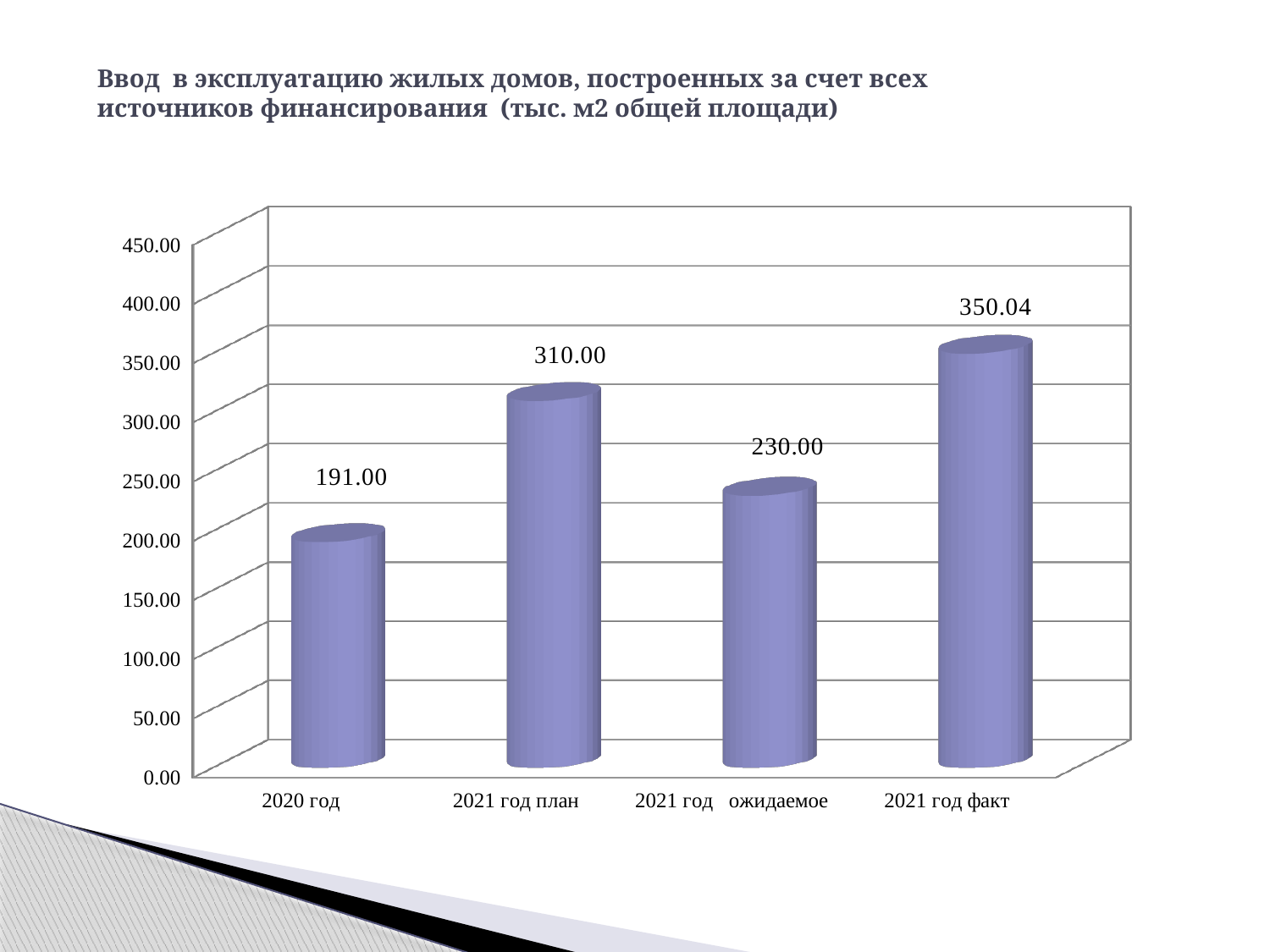
What is the value for 2021 год факт? 350.04 What is the difference between the values for 2021 год план and 2020 год? 119.00 How many categories are shown on the x axis? 4 Which category has the lowest value? 2020 год What is the unit of measurement given in the chart title? тыс. м2 общей площади What is the value for 2021 год план? 310.00 What is the difference between the values for 2021 год факт and 2021 год план? 40.04 What is the value for 2021 год ожидаемое? 230.00 What kind of chart is shown on the slide? bar chart Which is larger, the value for 2021 год план or 2021 год ожидаемое? 2021 год план What is the value for 2020 год? 191.00 Which category has the highest value? 2021 год факт